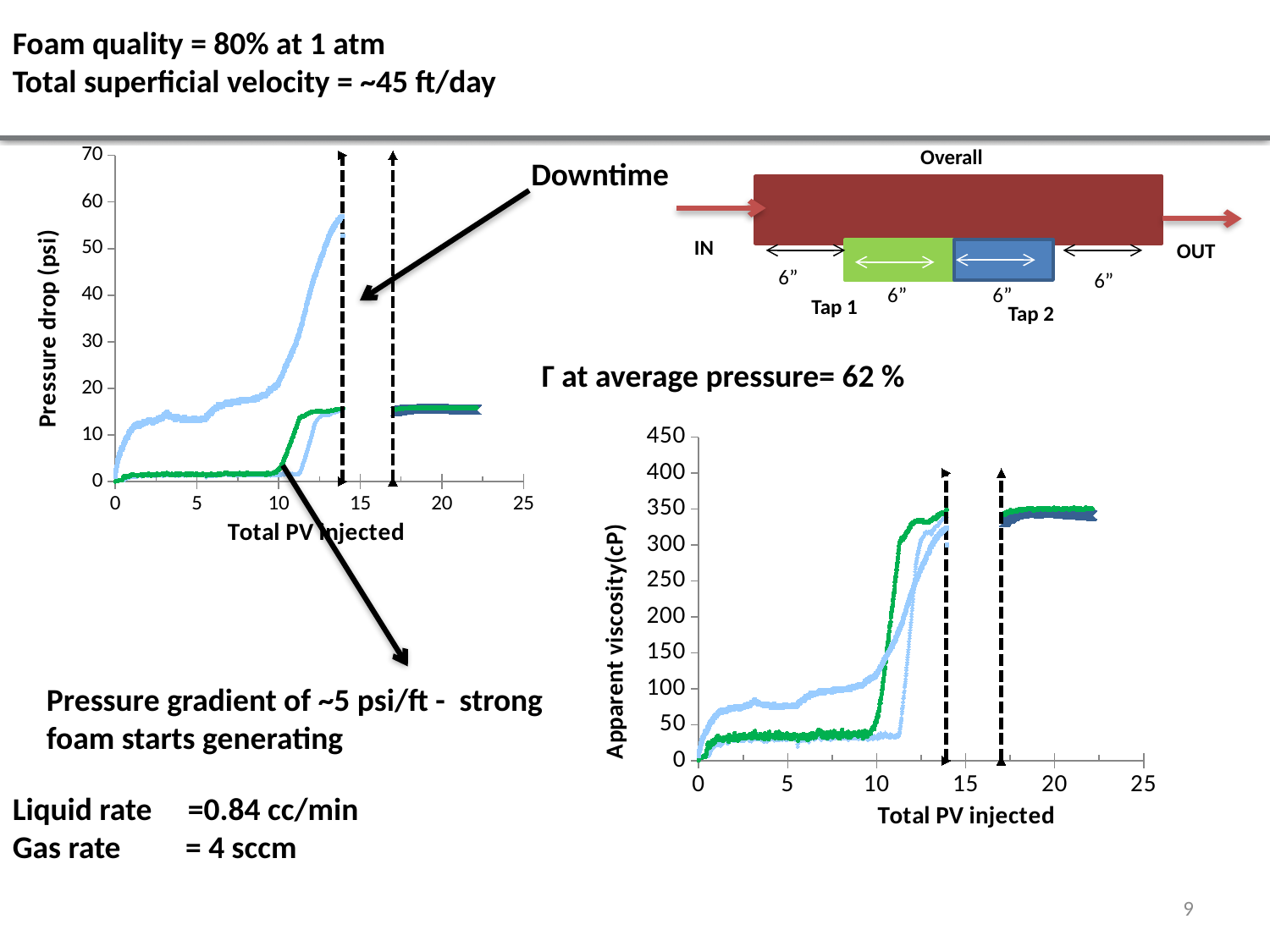
In the right chart, what is the label of the x axis? Total PV injected In the left chart, is the value of the green line at about 14 PV injected greater or less than 20? less What kind of chart is the chart with the y axis 'Apparent viscosity(cP)' on the right of the slide? line chart In the right chart, does the green line rise or fall between 10 and 14 PV injected? rise In the right chart, is the value of the green line at about 5 PV injected greater or less than 50? less In the left chart, at about 5 PV injected, which line has the higher pressure drop, the light blue line or the green line? the light blue line What kind of chart is the chart titled 'Pressure drop (psi)' on the left of the slide? line chart In the right chart, is the value of the light blue line at about 5 PV injected greater or less than 100? less In the left chart, what is the label of the y axis? Pressure drop (psi) In the left chart, does the light blue line rise or fall between 0 and 14 PV injected? rise